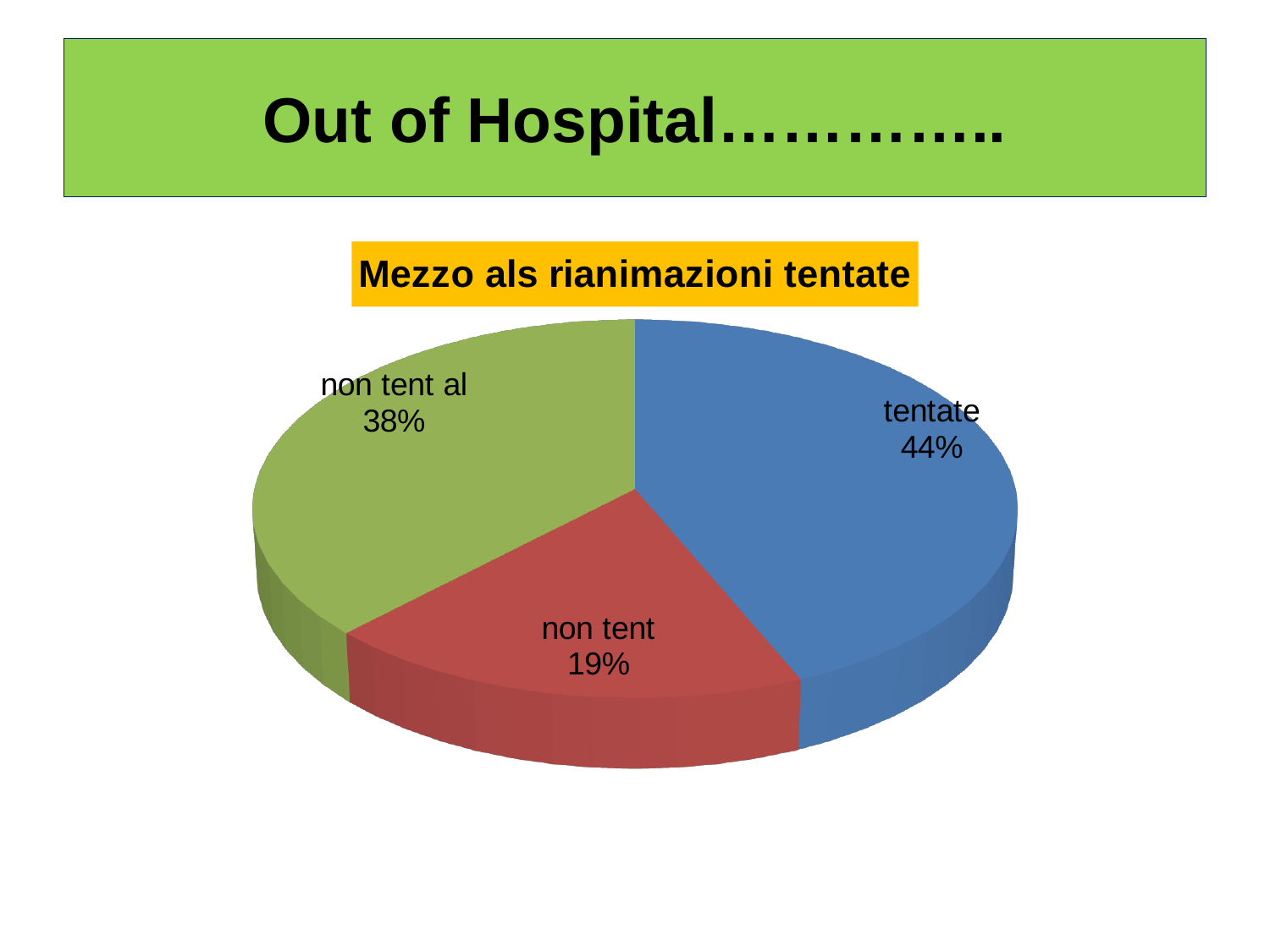
What percentage does the "non tent al" slice represent? 38% What is the difference in percentage points between "tentate" and "non tent"? 25 What kind of chart is shown on the slide? pie chart What percentage does the "tentate" slice represent? 44% Which slice of the pie is the smallest? non tent How many slices does the pie chart have? 3 What colour is the "non tent" slice? red Which slice of the pie is the largest? tentate What is the title of the chart? Mezzo als rianimazioni tentate What is the difference in percentage points between "non tent al" and "non tent"? 19 Which is larger, "tentate" or "non tent al"? tentate What percentage does the "non tent" slice represent? 19%